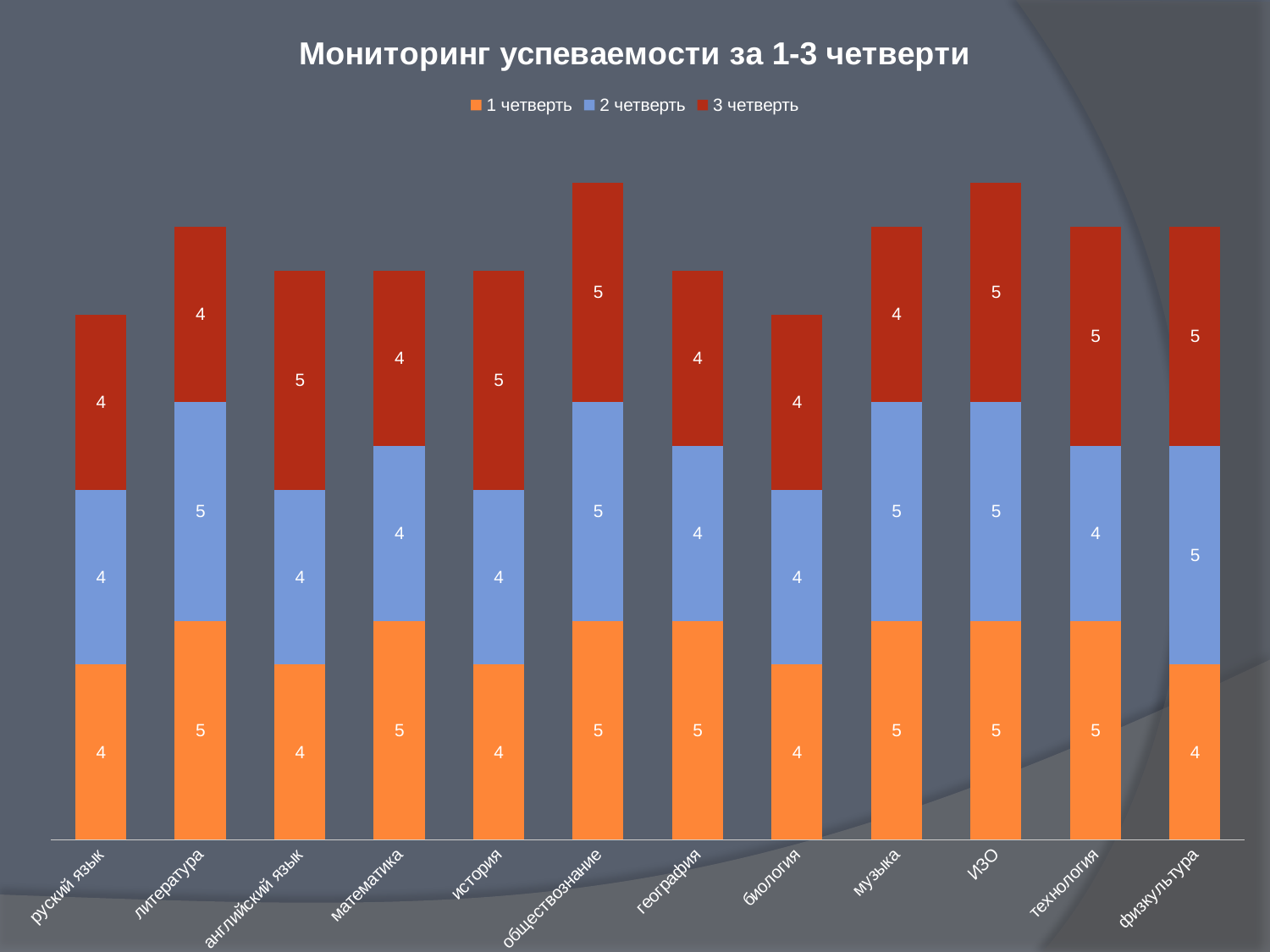
What is the total of the stacked bar for обществознание? 15 What is the difference between the 1 четверть value for литература and the 1 четверть value for биология? 1 What is the total of the stacked bar for технология? 14 What is the value for 3 четверть for английский язык? 5 What is the value for 2 четверть for физкультура? 5 What is the total of the stacked bar for руский язык? 12 What is the value for 3 четверть for литература? 4 Which is larger: the 3 четверть value for история or the 3 четверть value for география? история What is the value for 1 четверть for математика? 5 How many series does the legend list? 3 How many categories are shown on the x axis? 12 What kind of chart is shown on the slide? stacked bar chart